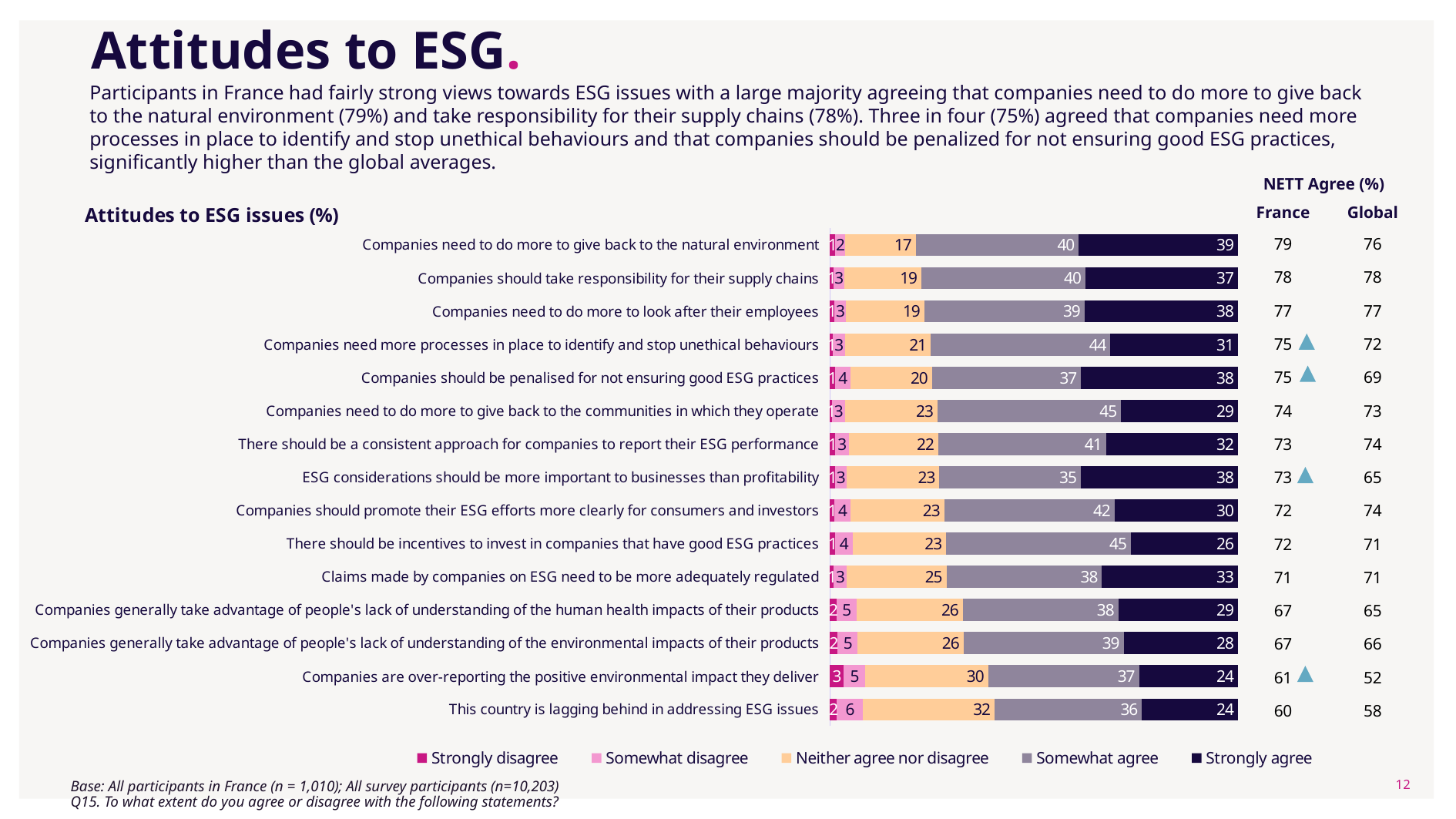
For 'Companies need more processes in place to identify and stop unethical behaviours', what is the difference between the Somewhat agree and Strongly agree values? 13 Which has the larger Strongly agree value: 'Companies should be penalised for not ensuring good ESG practices' or 'Companies need to do more to give back to the communities in which they operate'? Companies should be penalised for not ensuring good ESG practices What kind of chart is shown on the slide? Stacked bar chart What is the Neither agree nor disagree value for 'This country is lagging behind in addressing ESG issues'? 32 Which statement has the highest Neither agree nor disagree value? This country is lagging behind in addressing ESG issues How many series does the chart legend list? 5 What is the title of the chart? Attitudes to ESG issues (%) What is the Strongly agree value for 'Companies need to do more to give back to the natural environment'? 39 Which statement has the highest Strongly agree value? Companies need to do more to give back to the natural environment How many statements (categories) are plotted in the chart? 15 What is the total of all segments in the bar for 'Companies are over-reporting the positive environmental impact they deliver'? 99 What is the Somewhat agree value for 'Claims made by companies on ESG need to be more adequately regulated'? 38